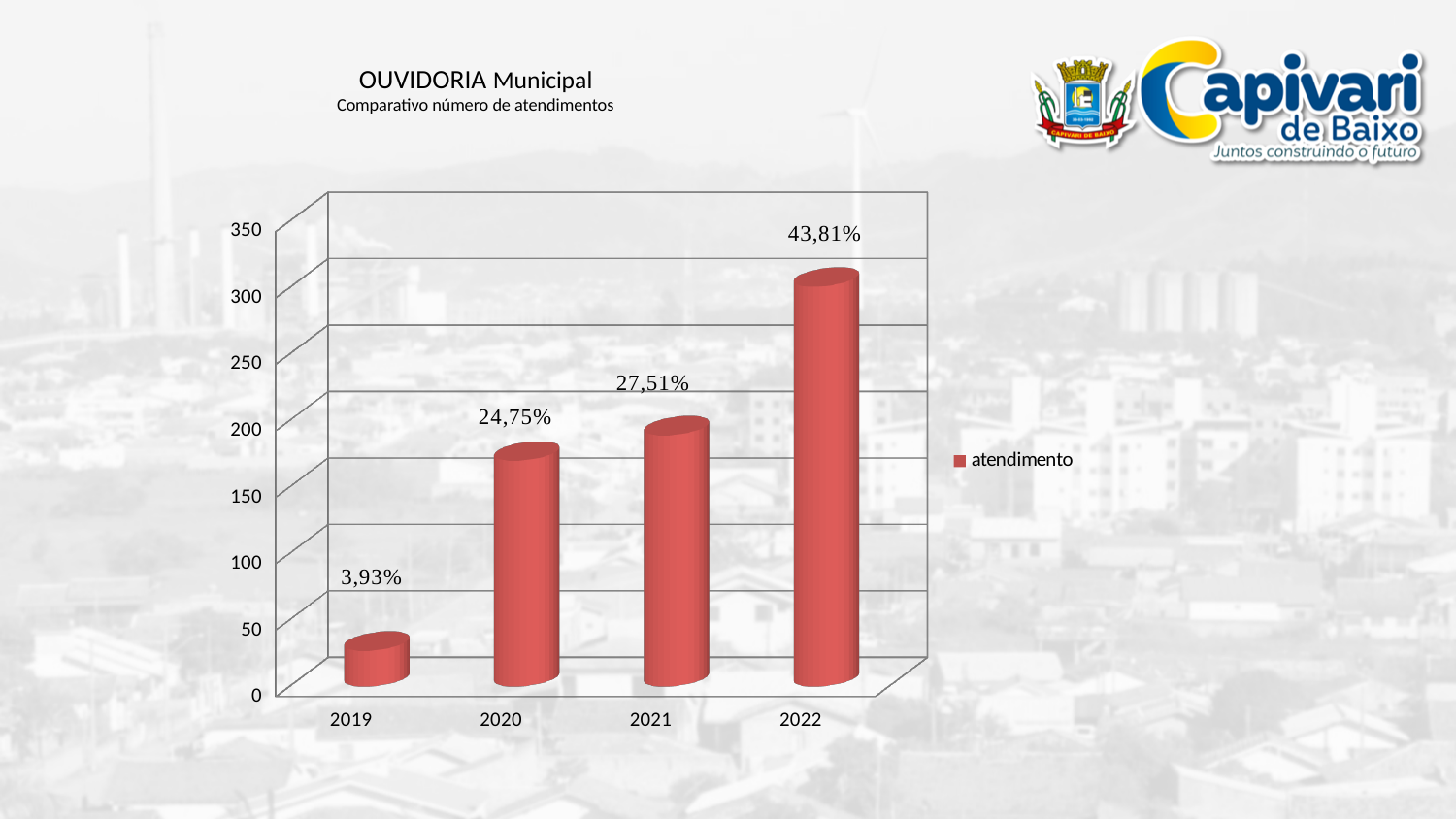
Is the value for 2022 greater or less than 250? greater Which year has the lowest bar? 2019 Is the value for 2019 greater or less than 50? less Which year has the highest bar? 2022 What is the difference between the data labels for 2022 and 2019? 39,88% What data label is shown for 2020? 24,75% Do the values rise or fall from 2019 to 2022? rise How many years are shown on the x axis? 4 Which year has a higher bar, 2020 or 2022? 2022 What data label is shown for 2022? 43,81% What data label is shown for 2021? 27,51% What data label is shown for 2019? 3,93%